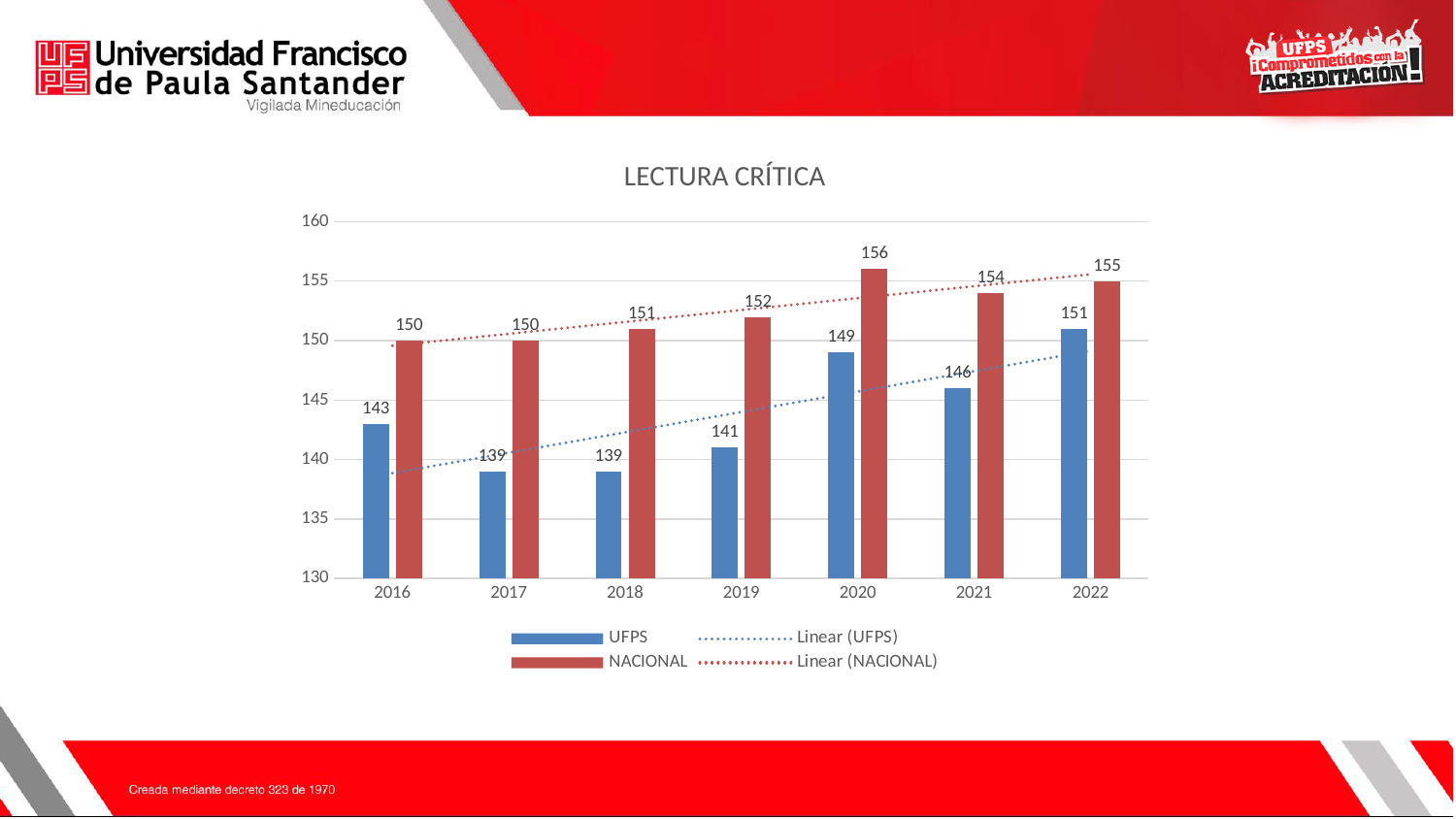
What is the difference between the NACIONAL and UFPS values in 2017? 11 Is the UFPS value for 2016 greater or less than 145? less Which is larger in 2021, the UFPS value or the NACIONAL value? NACIONAL What kind of chart is shown on the slide? bar chart How many years are shown on the x axis? 7 What is the NACIONAL value for 2019? 152 In which year is the UFPS value highest? 2022 How many entries does the legend list? 4 What is the title of the chart? LECTURA CRÍTICA What is the UFPS value for 2020? 149 In which year is the NACIONAL value highest? 2020 In which year is the UFPS value lowest? 2017 and 2018